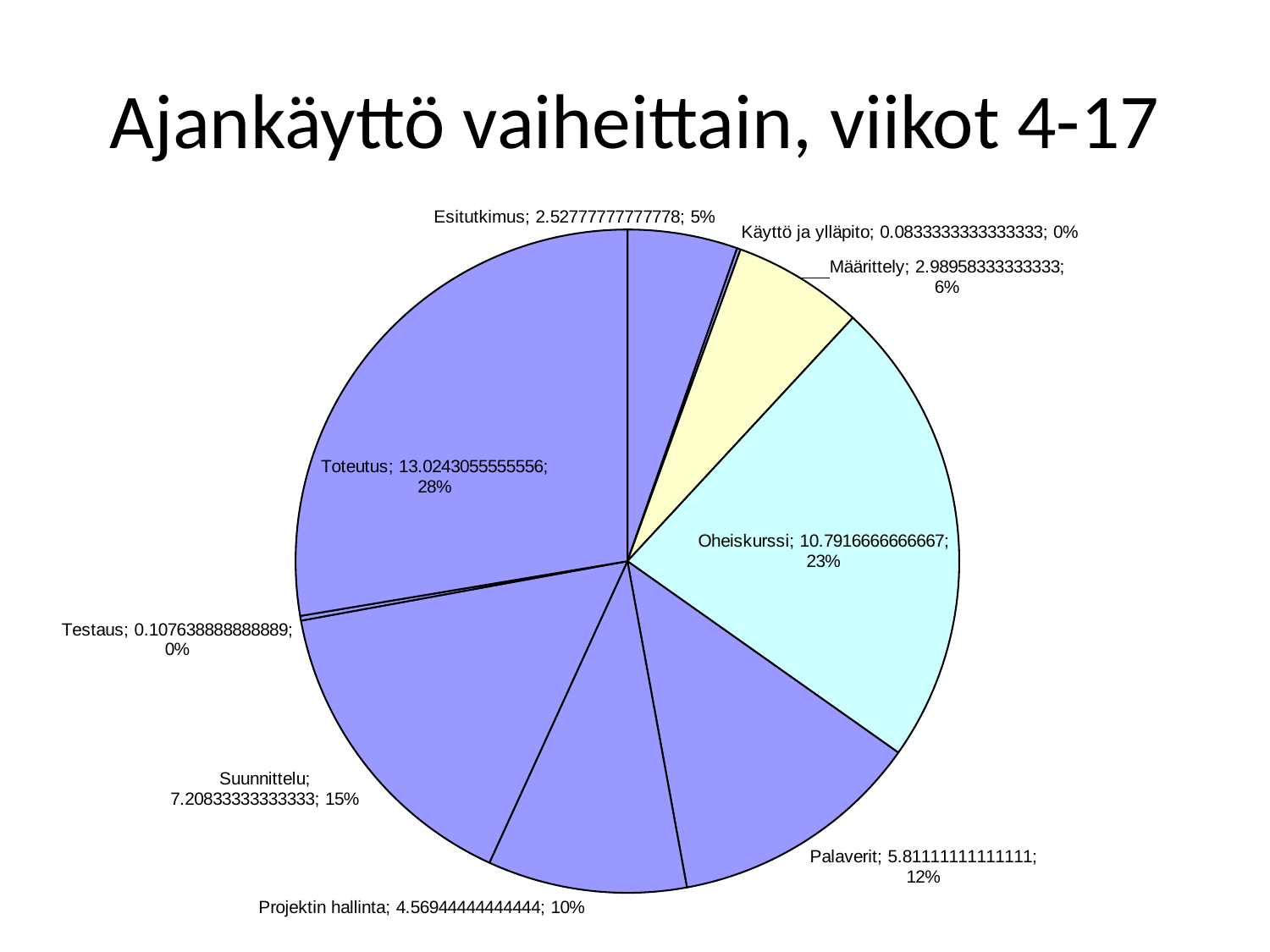
What is the value shown for Määrittely? 2.98958333333333 What share of the pie does Toteutus represent? 28% Which category has the smallest value in the pie chart? Käyttö ja ylläpito What kind of chart is shown on the slide? pie chart What is the difference in percentage share between Toteutus and Oheiskurssi? 5% Which has a larger share, Suunnittelu or Projektin hallinta? Suunnittelu What share of the pie does Oheiskurssi represent? 23% What is the value shown for Suunnittelu? 7.20833333333333 Which category has the largest slice of the pie? Toteutus How many slices does the pie chart have? 9 What is the title of the chart? Ajankäyttö vaiheittain, viikot 4-17 What is the value shown for Palaverit? 5.81111111111111